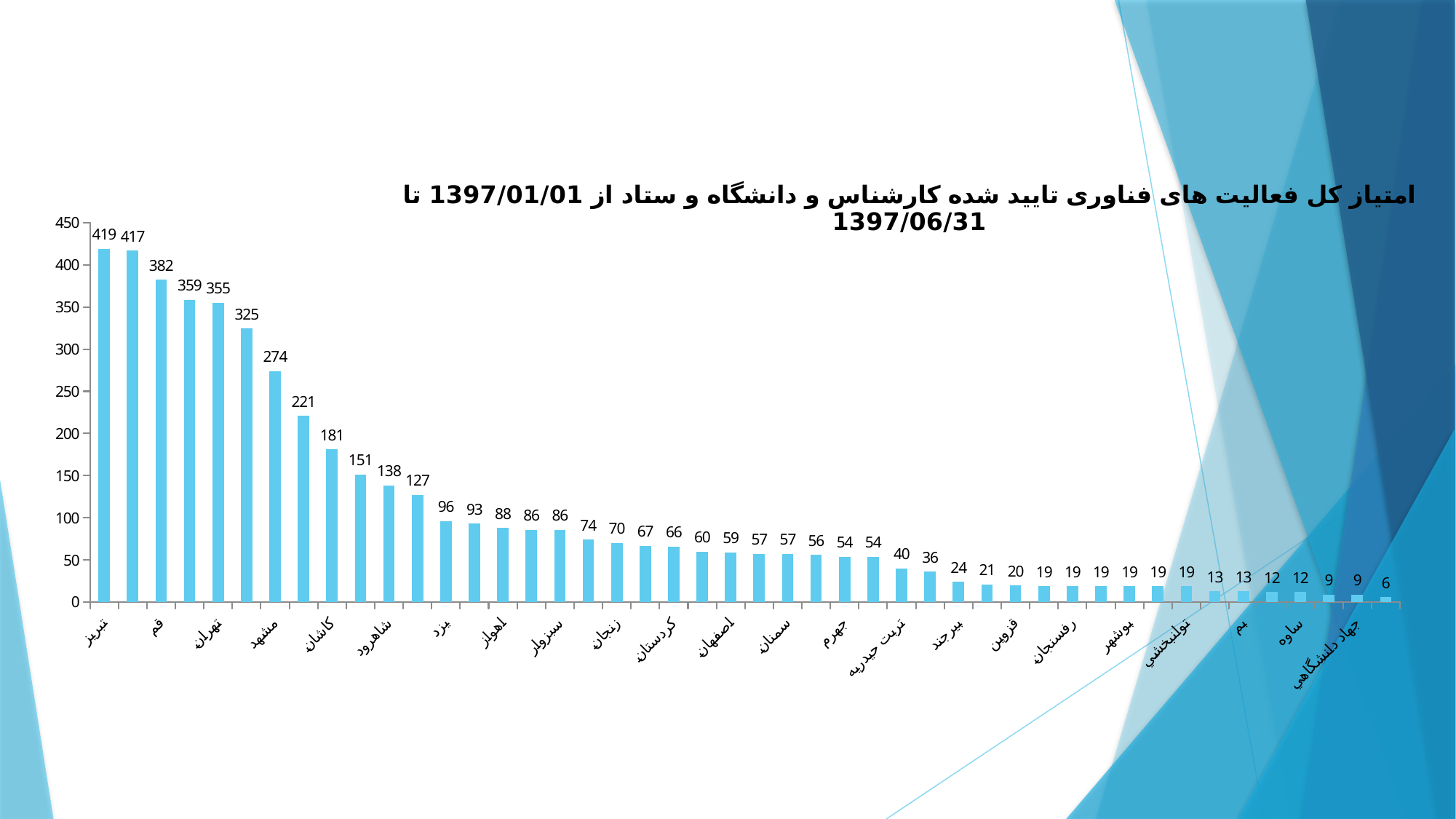
What is the difference between the highest value (419) and the lowest value (6)? 413 How many bars are plotted in the chart? 46 What is the value of the shortest bar in the chart? 6 Which category has the highest value in the chart? تبریز What is the value of the tallest bar in the chart? 419 What is the difference between the first two bars, 419 and 417? 2 What is the value for قم? 382 Do the bar values rise or fall from left to right along the x axis? fall Is the value for تبریز greater or less than 400? greater What is the value for تبریز? 419 What kind of chart is shown on the slide? bar chart Which is larger, the value for تبریز or the value for قم? تبریز